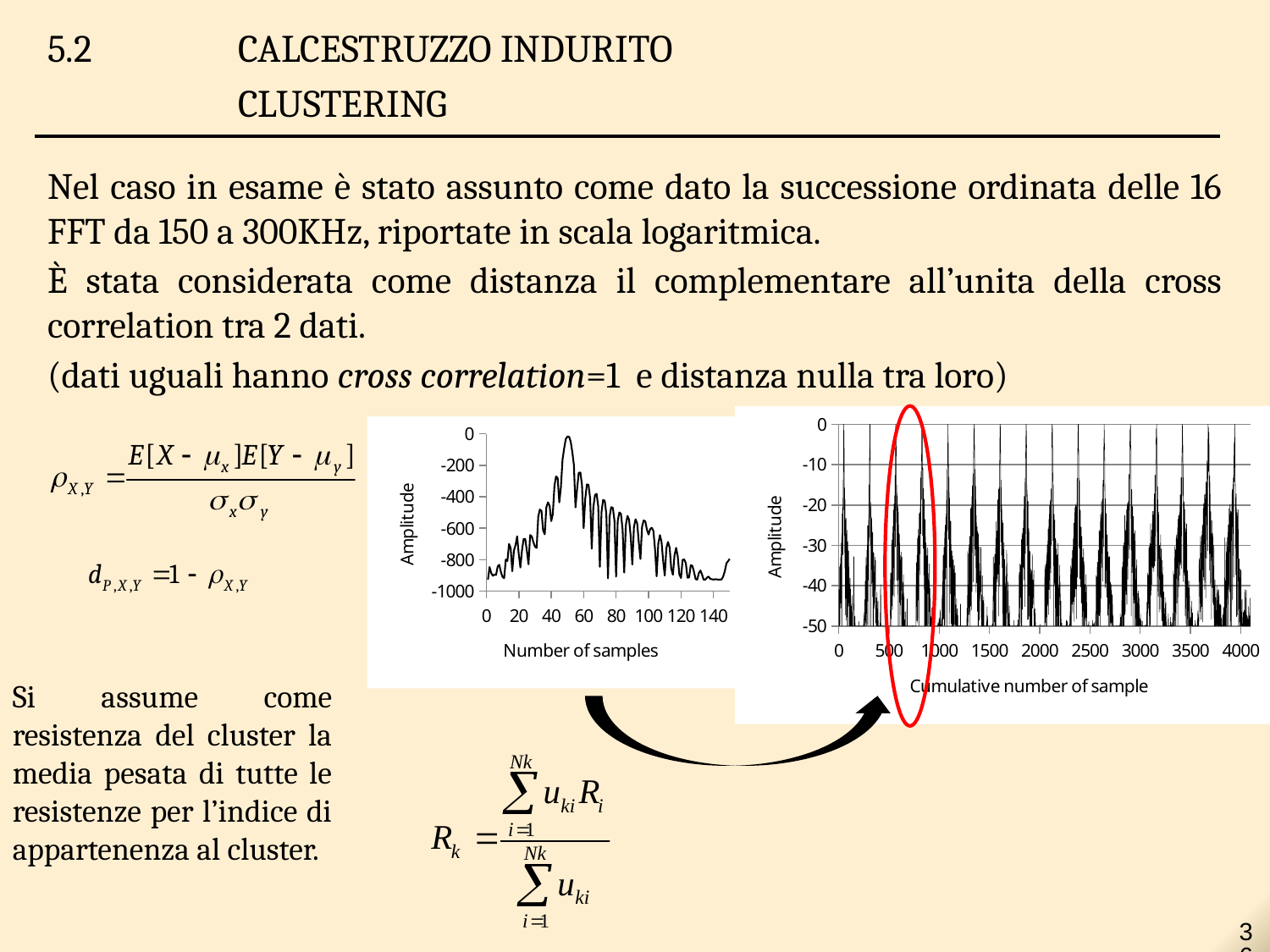
On the left chart, is the value at 60 samples greater or less than -800? greater On the left chart, does the line rise or fall between 0 and 50 samples? rise What kind of chart is the right chart with x axis 'Cumulative number of sample'? line chart On the left chart, is the value at 140 samples greater or less than -600? less On the right chart, is the lowest value of the line greater or less than -30? less On the right chart, what is the title of the x axis? Cumulative number of sample On the left chart, does the line rise or fall between 50 and 120 samples? fall On the left chart, what is the title of the x axis? Number of samples What kind of chart is the left chart with x axis 'Number of samples'? line chart